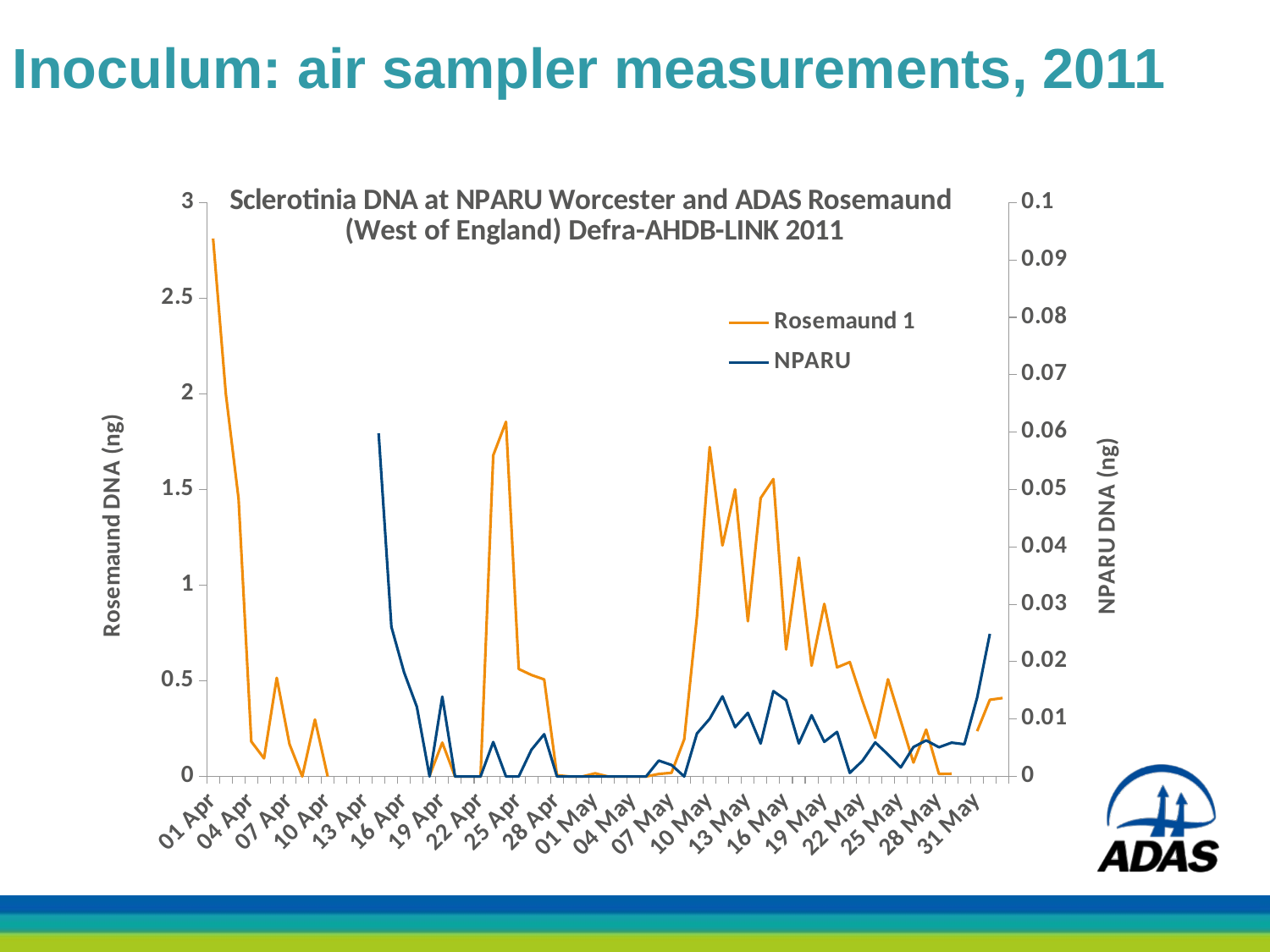
Which is larger for Rosemaund 1: the value on 01 Apr or the peak around 25 Apr? 01 Apr Is the NPARU value on 16 Apr greater or less than 0.05? less Is the Rosemaund 1 value on 01 Apr greater or less than 2.5? greater What kind of chart is shown on the slide? line chart Does the Rosemaund 1 series rise or fall between 01 Apr and 07 Apr? fall On which date does the Rosemaund 1 series reach its highest value? 01 Apr Is the NPARU value on 31 May greater or less than 0.02? less What are the two series named in the chart legend? Rosemaund 1 and NPARU What is the label of the right-hand vertical axis? NPARU DNA (ng) How many series does the chart legend list? 2